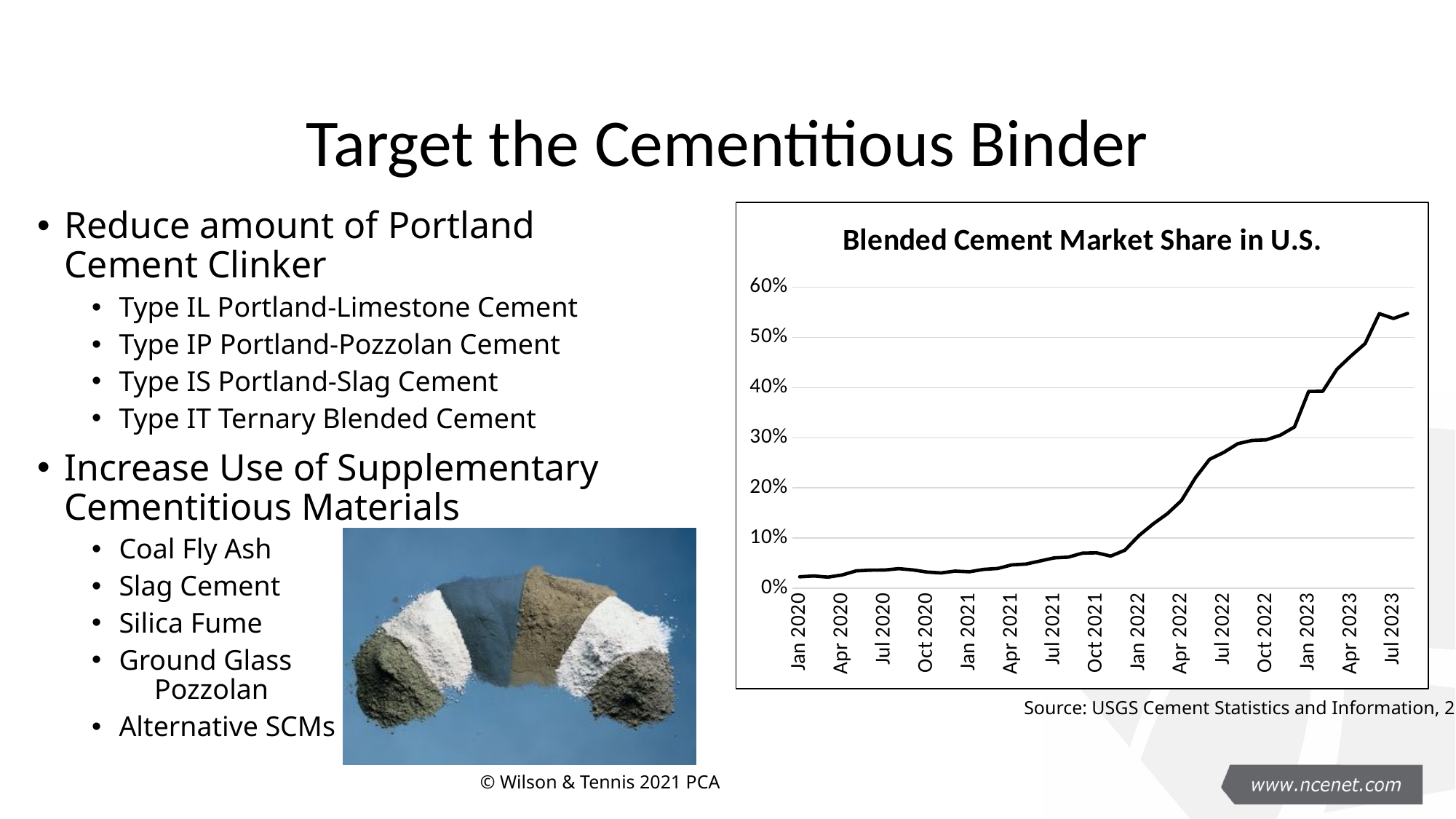
Is the value for Apr 2022 greater or less than 20%? less What is the highest value shown on the y axis of the chart? 60% Which is larger, the value for Jan 2020 or the value for Jul 2023? Jul 2023 Is the value for Apr 2023 greater or less than 40%? greater What kind of chart is "Blended Cement Market Share in U.S."? line chart What is the title of the chart on the slide? Blended Cement Market Share in U.S. Is the value for Jul 2022 greater or less than 20%? greater Does the blended cement market share generally rise or fall from Jan 2020 to Jul 2023? rise How many date labels are shown on the x axis of the chart? 15